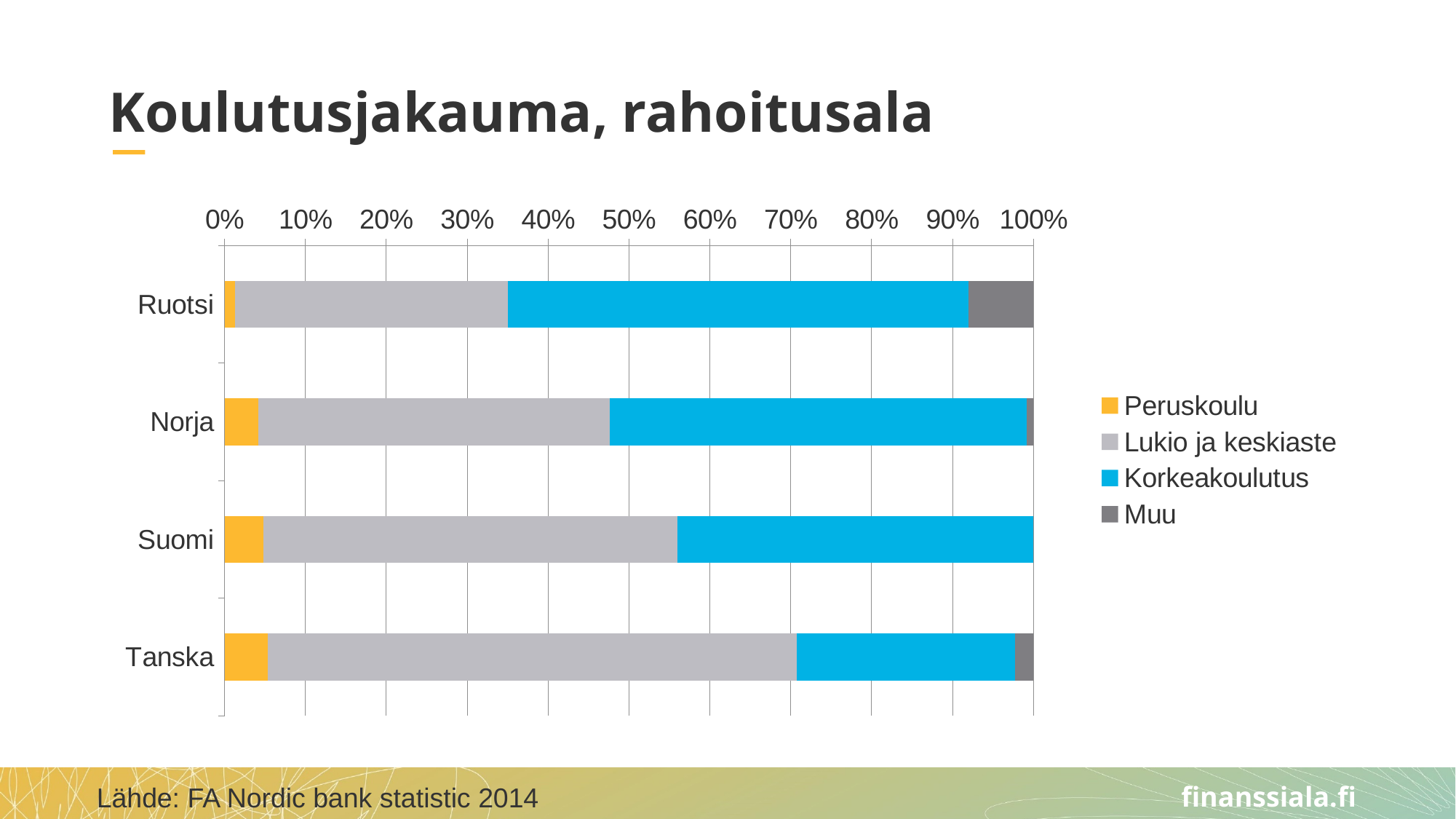
Is the Lukio ja keskiaste share for Tanska greater or less than 60%? greater Which series is shown in orange in the legend? Peruskoulu Is the Korkeakoulutus share for Tanska greater or less than 40%? less What kind of chart is shown on the slide? Stacked bar chart Which country has the largest Lukio ja keskiaste share? Tanska Is the Korkeakoulutus share for Ruotsi greater or less than 50%? greater Which has the larger Lukio ja keskiaste share, Suomi or Norja? Suomi How many series does the legend list? 4 How many countries are shown on the chart? 4 Which country has the largest Muu share? Ruotsi Which country has the smallest Korkeakoulutus share? Tanska What is the title of the chart slide? Koulutusjakauma, rahoitusala